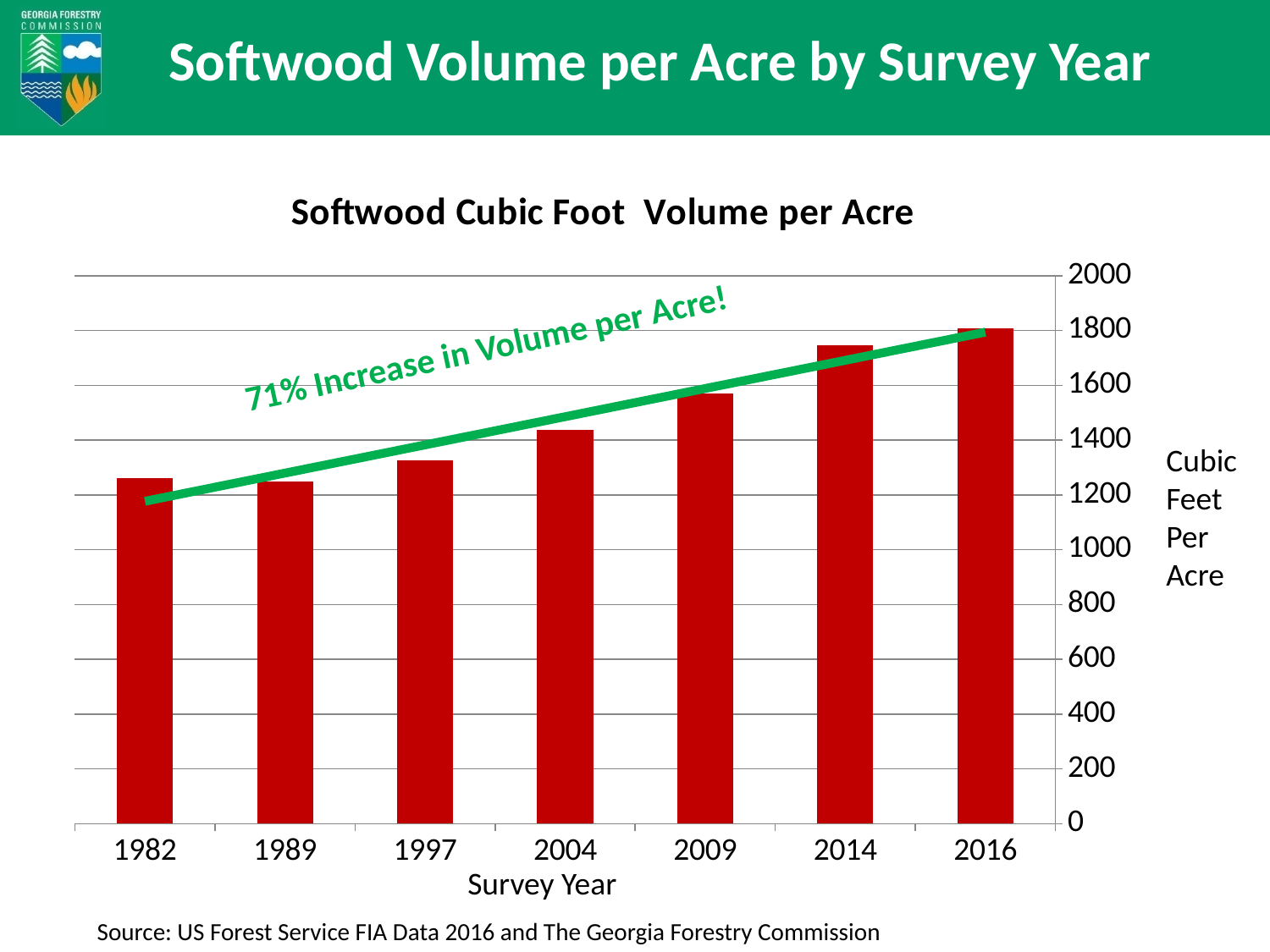
Is the value for 2016 greater or less than 1600? greater Do the values generally rise or fall from 1982 to 2016? rise What is the title of the chart? Softwood Cubic Foot Volume per Acre Which survey year has the highest softwood volume per acre? 2016 Which has a larger softwood volume per acre, 2009 or 2014? 2014 How many survey years are plotted on the chart? 7 What percentage increase in volume per acre does the annotation on the chart state? 71% What kind of chart is shown on the slide? bar chart Is the value for 2014 greater or less than 1600? greater Is the value for 2009 greater or less than 1600? less